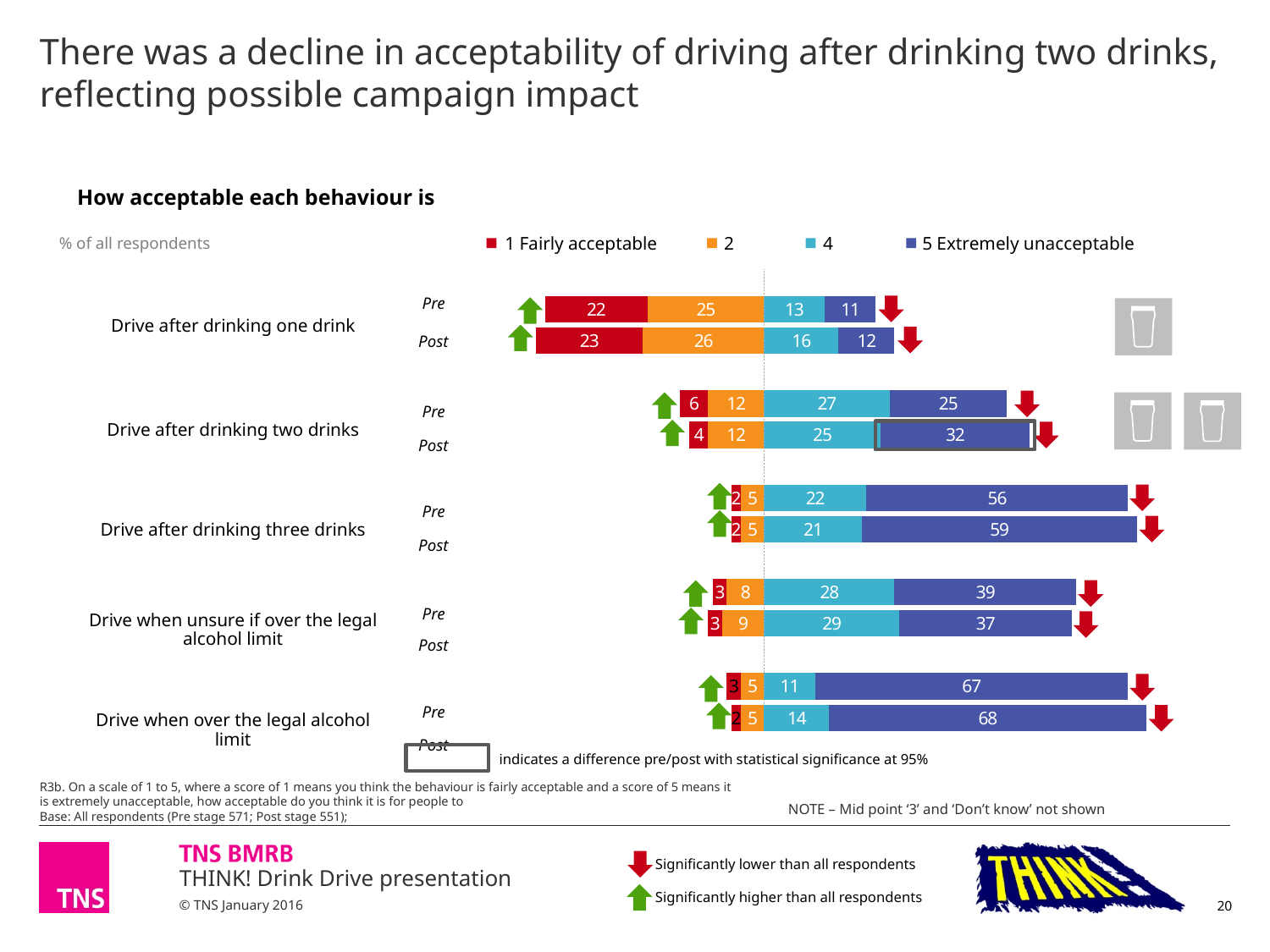
How many behaviours are shown on the chart? 5 What percentage of respondents rated 'Drive after drinking two drinks' as 5 Extremely unacceptable at the Post stage? 32 What is the '4' value for 'Drive when unsure if over the legal alcohol limit' at the Post stage? 29 What kind of chart is shown on the slide? Stacked bar chart By how much did the '5 Extremely unacceptable' value for 'Drive after drinking two drinks' change from Pre to Post? 7 Which bar has the highest '5 Extremely unacceptable' value? Drive when over the legal alcohol limit, Post For 'Drive after drinking one drink' at the Post stage, which is larger: the '2' value or the '4' value? 2 (26) How many series does the legend list? 4 What is the '1 Fairly acceptable' value for 'Drive after drinking one drink' at the Pre stage? 22 Which bar has the highest '1 Fairly acceptable' value? Drive after drinking one drink, Post What is the '5 Extremely unacceptable' value for 'Drive when over the legal alcohol limit' at the Pre stage? 67 What is the difference between the Post and Pre '5 Extremely unacceptable' values for 'Drive after drinking three drinks'? 3